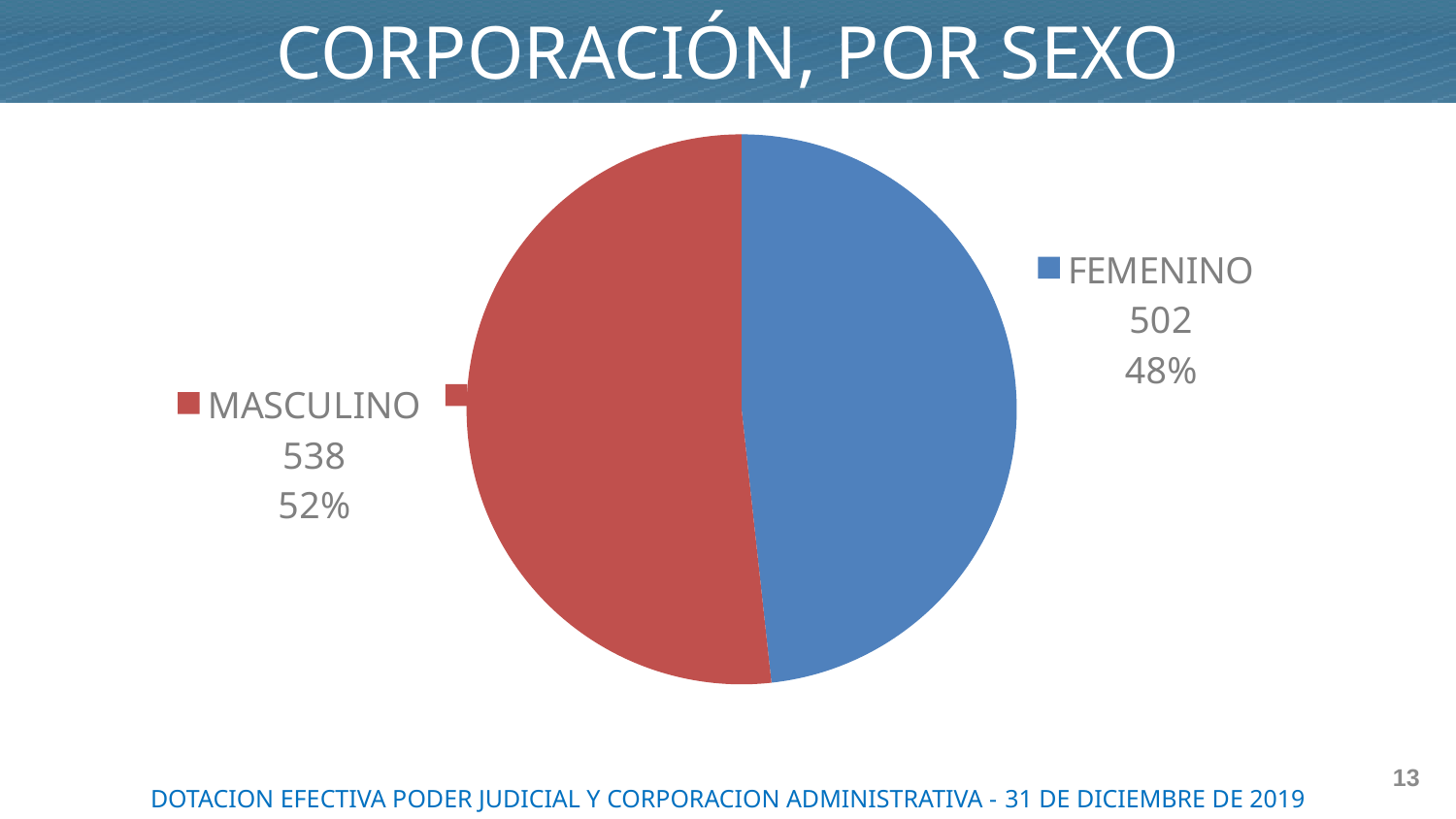
What is the value for MASCULINO? 538 What colour is the FEMENINO slice? blue What is the difference between the MASCULINO and FEMENINO values? 36 What is the value for FEMENINO? 502 How many slices does the pie chart have? 2 Which is larger, the value for MASCULINO or the value for FEMENINO? MASCULINO What percentage share does the FEMENINO slice represent? 48% What kind of chart is shown on the slide? pie chart What percentage share does the MASCULINO slice represent? 52% Which category has the smallest slice? FEMENINO Which category has the largest slice? MASCULINO What is the total of the two slices? 1040